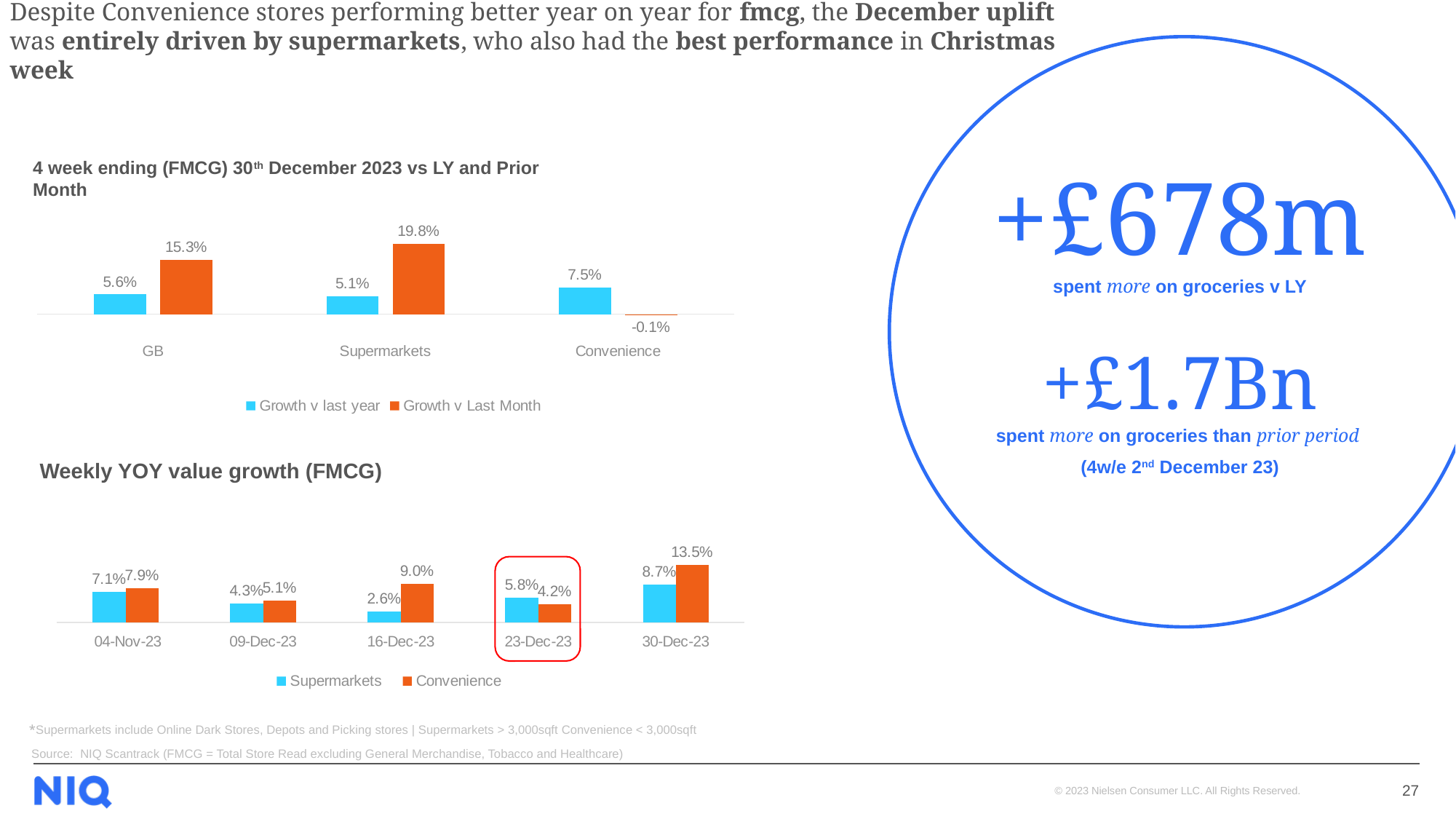
In the 'Weekly YOY value growth (FMCG)' chart, which week has the highest Supermarkets value? 30-Dec-23 In the '4 week ending (FMCG) 30th December 2023 vs LY and Prior Month' chart, what is the difference between the Growth v Last Month and Growth v last year values for GB? 9.7% In the 'Weekly YOY value growth (FMCG)' chart, what is the Supermarkets value for 16-Dec-23? 2.6% In the '4 week ending (FMCG) 30th December 2023 vs LY and Prior Month' chart, what is the Growth v Last Month value for Supermarkets? 19.8% In the 'Weekly YOY value growth (FMCG)' chart, which is larger for 23-Dec-23: Supermarkets or Convenience? Supermarkets In the '4 week ending (FMCG) 30th December 2023 vs LY and Prior Month' chart, what is the Growth v last year value for Convenience? 7.5% How many weeks are shown on the x axis of the 'Weekly YOY value growth (FMCG)' chart? 5 In the 'Weekly YOY value growth (FMCG)' chart, what is the difference between the Convenience and Supermarkets values for 16-Dec-23? 6.4% In the 'Weekly YOY value growth (FMCG)' chart, what is the Convenience value for 30-Dec-23? 13.5% In the '4 week ending (FMCG) 30th December 2023 vs LY and Prior Month' chart, which category has the lowest Growth v Last Month value? Convenience In the '4 week ending (FMCG) 30th December 2023 vs LY and Prior Month' chart, how many series does the legend list? 2 What type of chart is the 'Weekly YOY value growth (FMCG)' chart? Bar chart